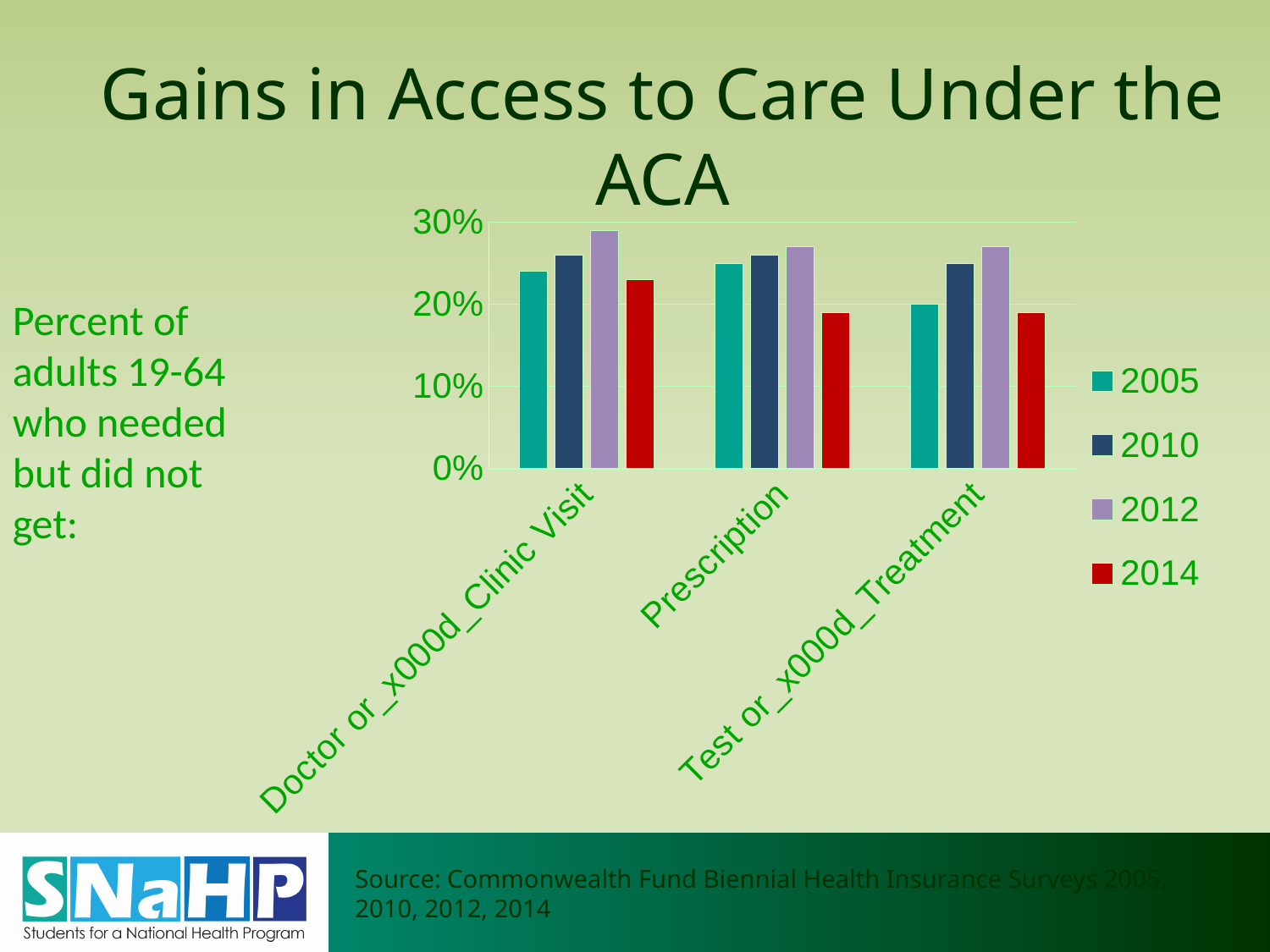
For Test or Treatment, which is larger: the 2005 value or the 2010 value? 2010 How many series does the chart's legend list? 4 How many categories are shown on the x axis of the chart? 3 Is the 2012 value for Doctor or Clinic Visit greater or less than 20%? greater For Doctor or Clinic Visit, which year has the highest value? 2012 What colour are the bars for the 2014 series? red Which years are listed in the chart's legend? 2005, 2010, 2012, 2014 For Prescription, which year has the lowest value? 2014 What kind of chart is shown on the slide? bar chart For the 2014 series, does the value rise or fall from Doctor or Clinic Visit to Prescription? fall